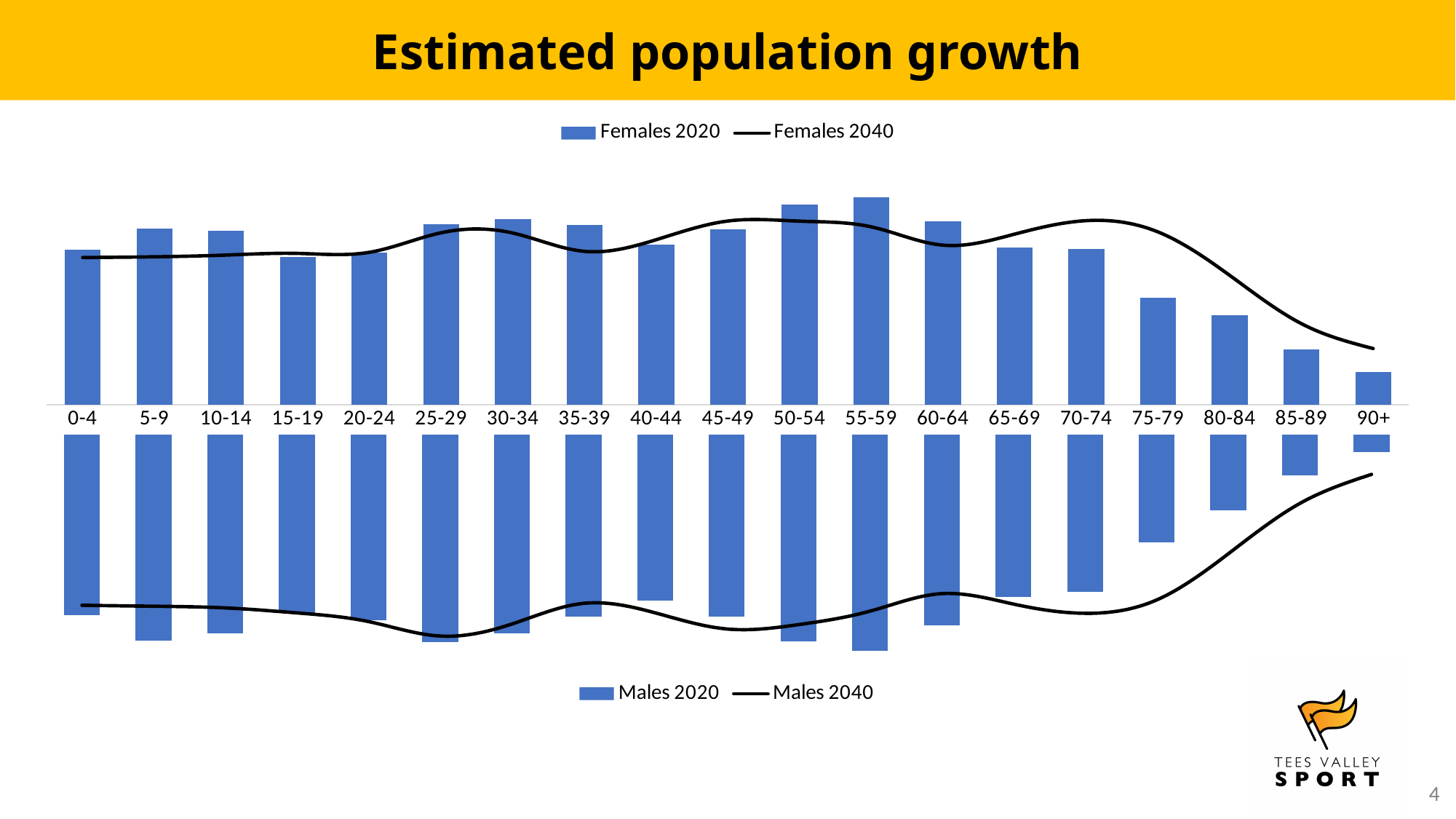
In the top chart (Females), which age group has the tallest Females 2020 bar? 55-59 What kind of chart is used for the Females 2020 series in the top chart? Bar chart In the top chart (Females), is the Females 2020 bar larger for 75-79 or for 80-84? 75-79 In the top chart (Females), which age group has the shortest Females 2020 bar? 90+ In the bottom chart (Males), which age group has the shortest Males 2020 bar? 90+ In the bottom chart (Males), is the Males 2020 bar larger for 65-69 or for 75-79? 65-69 What are the two legend entries of the bottom chart (Males)? Males 2020 and Males 2040 How many age groups are shown along the x axis of the top chart (Females)? 19 How many series does the legend of the bottom chart (Males) list? 2 How many series does the legend of the top chart (Females) list? 2 In the bottom chart (Males), which age group has the longest Males 2020 bar? 55-59 In the top chart (Females), do the Females 2020 bars rise or fall from 65-69 to 90+? Fall